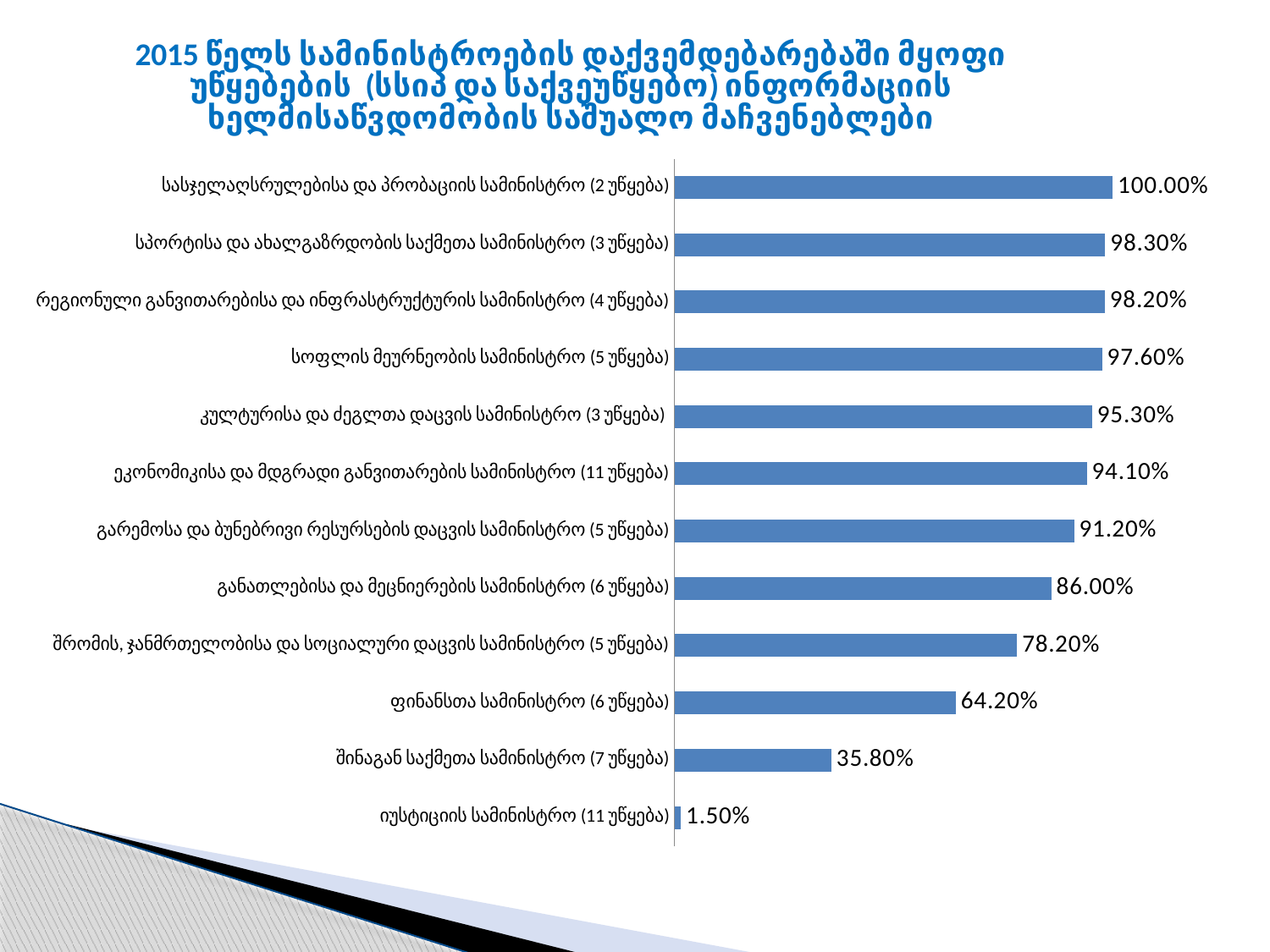
Which category has the highest value in the chart? სასჯელაღსრულებისა და პრობაციის სამინისტრო (2 უწყება) Which category has the lowest value in the chart? იუსტიციის სამინისტრო (11 უწყება) What is the value for სასჯელაღსრულებისა და პრობაციის სამინისტრო (2 უწყება)? 100.00% What is the difference between the values for სასჯელაღსრულებისა და პრობაციის სამინისტრო (2 უწყება) and იუსტიციის სამინისტრო (11 უწყება)? 98.50% What type of chart is shown on the slide? bar chart What is the value for კულტურისა და ძეგლთა დაცვის სამინისტრო (3 უწყება)? 95.30% What is the value for შინაგან საქმეთა სამინისტრო (7 უწყება)? 35.80% What is the value for განათლებისა და მეცნიერების სამინისტრო (6 უწყება)? 86.00% Which has a larger value: შრომის, ჯანმრთელობისა და სოციალური დაცვის სამინისტრო (5 უწყება) or ფინანსთა სამინისტრო (6 უწყება)? შრომის, ჯანმრთელობისა და სოციალური დაცვის სამინისტრო (5 უწყება) How many categories (ministries) are plotted in the chart? 12 What is the value for ფინანსთა სამინისტრო (6 უწყება)? 64.20% What is the difference between the values for ფინანსთა სამინისტრო (6 უწყება) and შინაგან საქმეთა სამინისტრო (7 უწყება)? 28.40%